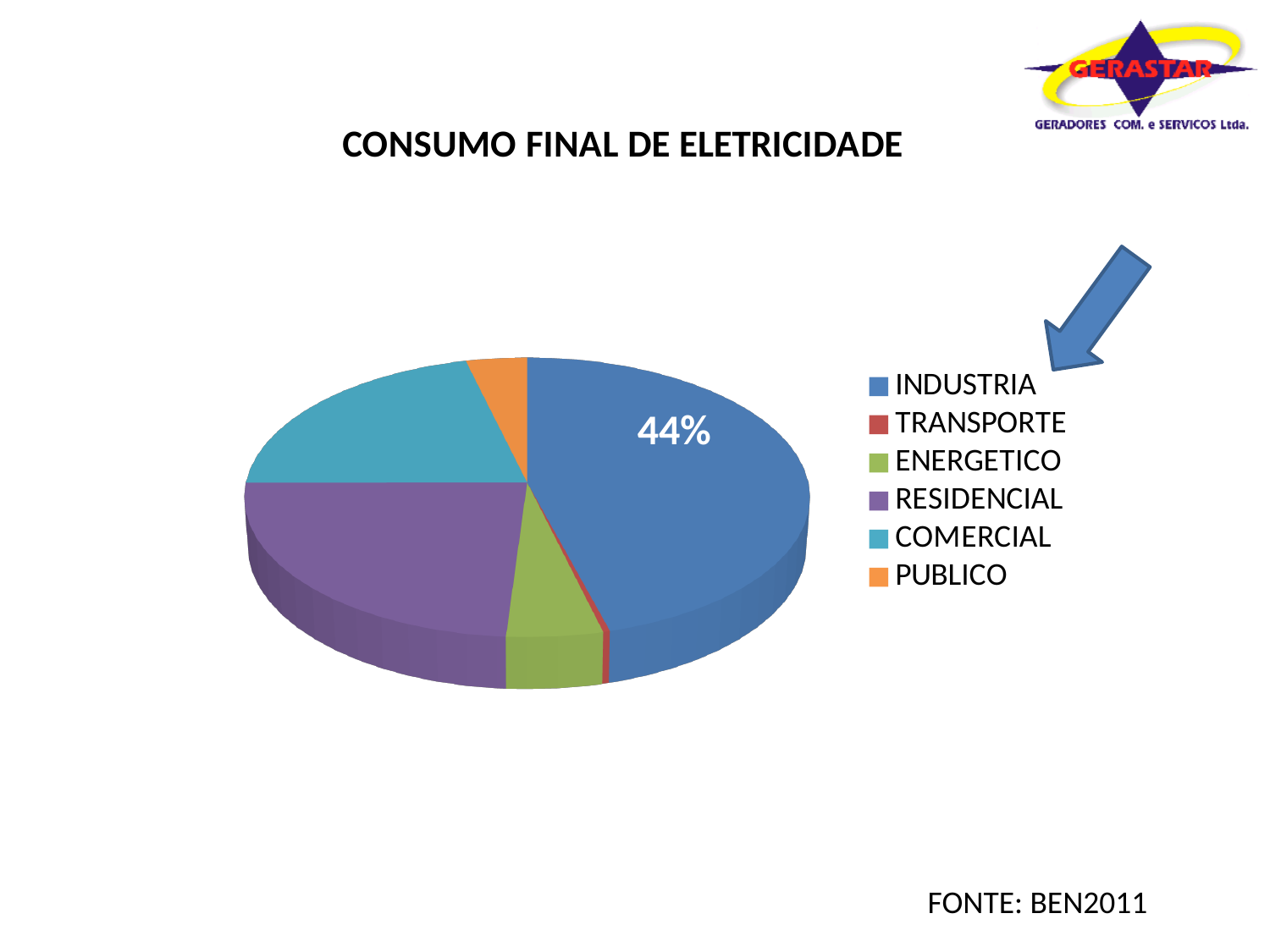
Which category has the largest slice of the pie? INDUSTRIA Which slice is larger, RESIDENCIAL or ENERGETICO? RESIDENCIAL Which category has the smallest slice of the pie? TRANSPORTE What is the title of the chart? CONSUMO FINAL DE ELETRICIDADE What share of the pie does INDUSTRIA represent? 44% Which slice is larger, INDUSTRIA or RESIDENCIAL? INDUSTRIA What kind of chart is shown on the slide? Pie chart Which slice is larger, COMERCIAL or PUBLICO? COMERCIAL What is the value printed on the INDUSTRIA slice? 44% How many categories does the pie chart have? 6 Which category is shown in orange in the legend? PUBLICO